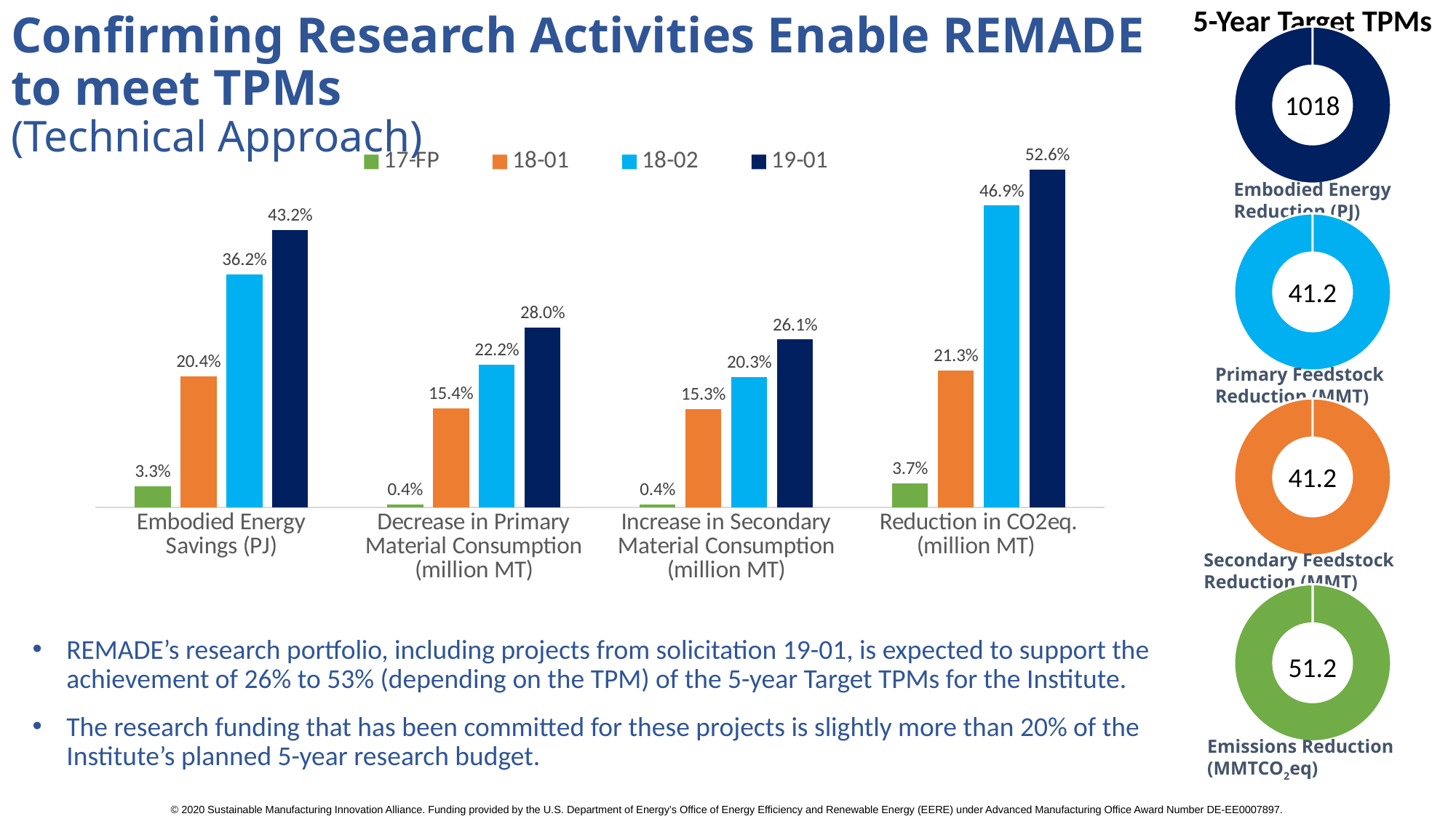
How many categories are shown on the x axis of the bar chart? 4 In the bar chart, which category has the highest 19-01 value? Reduction in CO2eq. (million MT) What kind of chart is the large chart on the left of the slide? Bar chart In the bar chart, what is the 18-01 value for Decrease in Primary Material Consumption (million MT)? 15.4% In the bar chart, what is the 17-FP value for Increase in Secondary Material Consumption (million MT)? 0.4% In the bar chart, what is the difference between the 19-01 and 18-02 values for Embodied Energy Savings (PJ)? 7.0% In the 5-Year Target TPMs donut charts, what value is shown for Emissions Reduction (MMTCO2eq)? 51.2 In the bar chart, which series has the lowest value for Reduction in CO2eq. (million MT)? 17-FP How many series does the legend of the bar chart list? 4 In the bar chart, which is larger: the 18-02 value for Decrease in Primary Material Consumption or the 18-02 value for Increase in Secondary Material Consumption? Decrease in Primary Material Consumption In the bar chart, what is the 19-01 value for Embodied Energy Savings (PJ)? 43.2% In the bar chart, what is the 18-02 value for Reduction in CO2eq. (million MT)? 46.9%